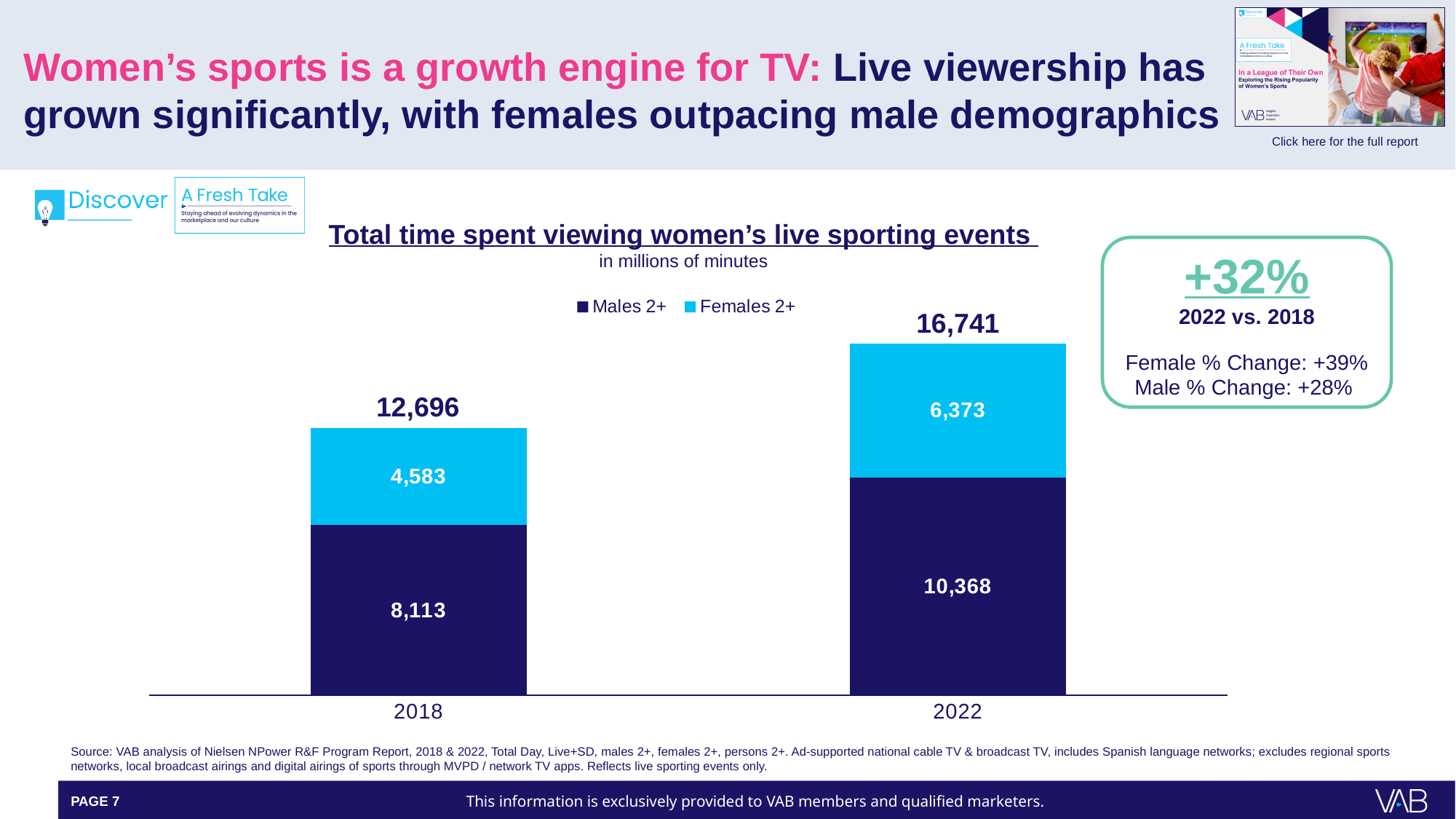
What is the total of the stacked bar for 2022? 16,741 What kind of chart is shown on the slide? Stacked bar chart What is the value for Females 2+ in 2018? 4,583 What is the difference between the Males 2+ values for 2022 and 2018? 2,255 What is the total of the stacked bar for 2018? 12,696 Which is larger in 2018, the Males 2+ value or the Females 2+ value? Males 2+ What is the value for Females 2+ in 2022? 6,373 How many series does the legend list? 2 What is the value for Males 2+ in 2018? 8,113 Which year has the higher total time spent viewing? 2022 What is the value for Males 2+ in 2022? 10,368 What is the difference between the Females 2+ values for 2022 and 2018? 1,790